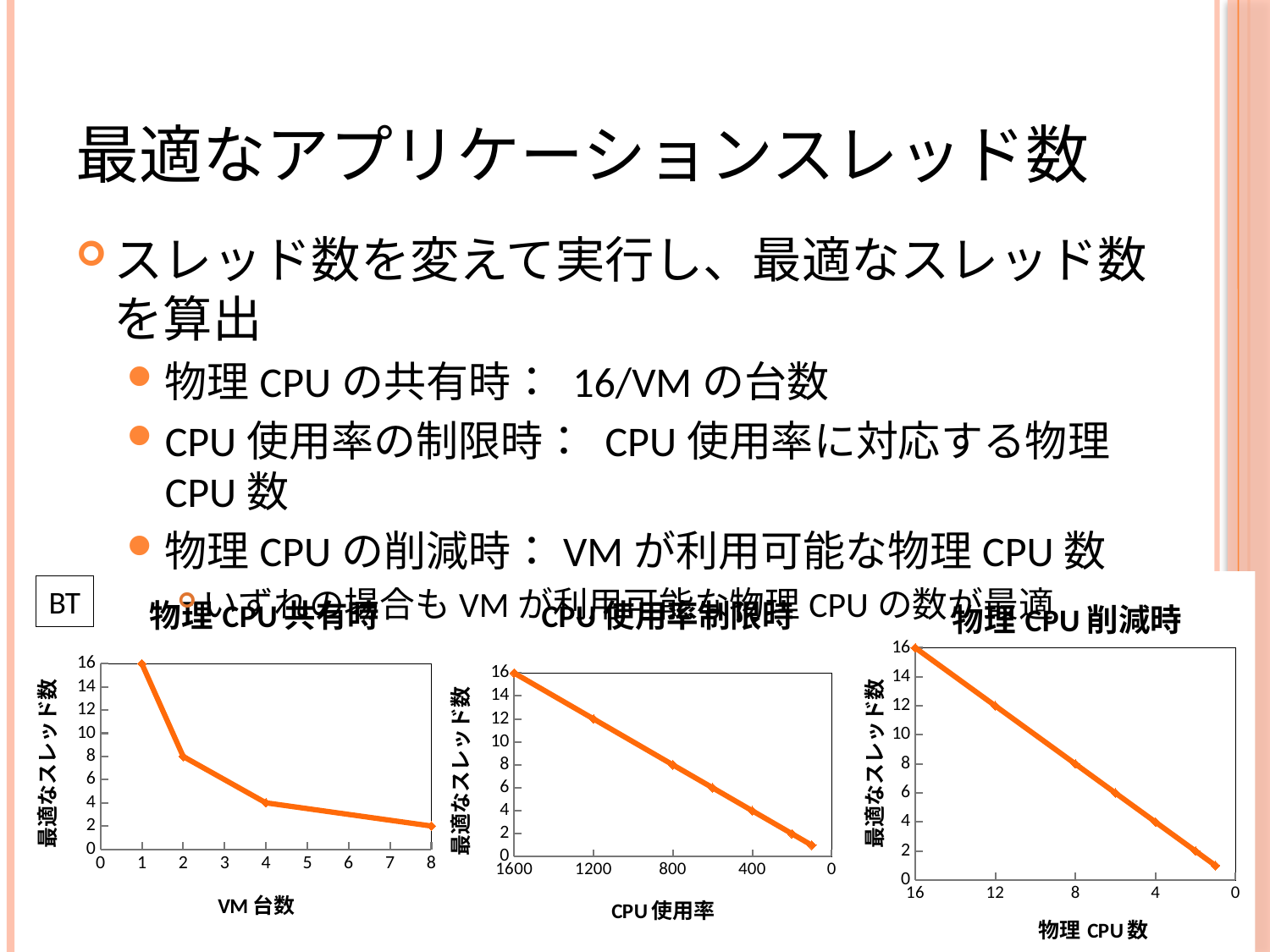
In the chart titled 物理CPU共有時, how many data points are plotted? 4 In the chart titled 物理CPU共有時, what is the difference between the optimal thread count at 1 VM and at 2 VMs? 8 In the rightmost chart titled 物理CPU削減時, what is the optimal thread count when the number of physical CPUs (物理CPU数) is 16? 16 What kind of chart is the leftmost chart titled 物理CPU共有時? line chart In the chart titled 物理CPU共有時, what is the optimal thread count (最適なスレッド数) when the number of VMs (VM台数) is 1? 16 What is the y-axis label shared by all three charts on the slide? 最適なスレッド数 In the chart titled 物理CPU共有時, what is the optimal thread count when the number of VMs is 2? 8 In the chart titled 物理CPU共有時, do the values rise or fall as the number of VMs increases? fall In the middle chart titled CPU使用率制限時, what is the optimal thread count when CPU使用率 is 800? 8 In the middle chart titled CPU使用率制限時, what is the optimal thread count when CPU使用率 is 1200? 12 In the rightmost chart titled 物理CPU削減時, which is larger: the optimal thread count at 12 physical CPUs or at 4 physical CPUs? 12 physical CPUs In the chart titled 物理CPU共有時, what is the optimal thread count when the number of VMs is 8? 2